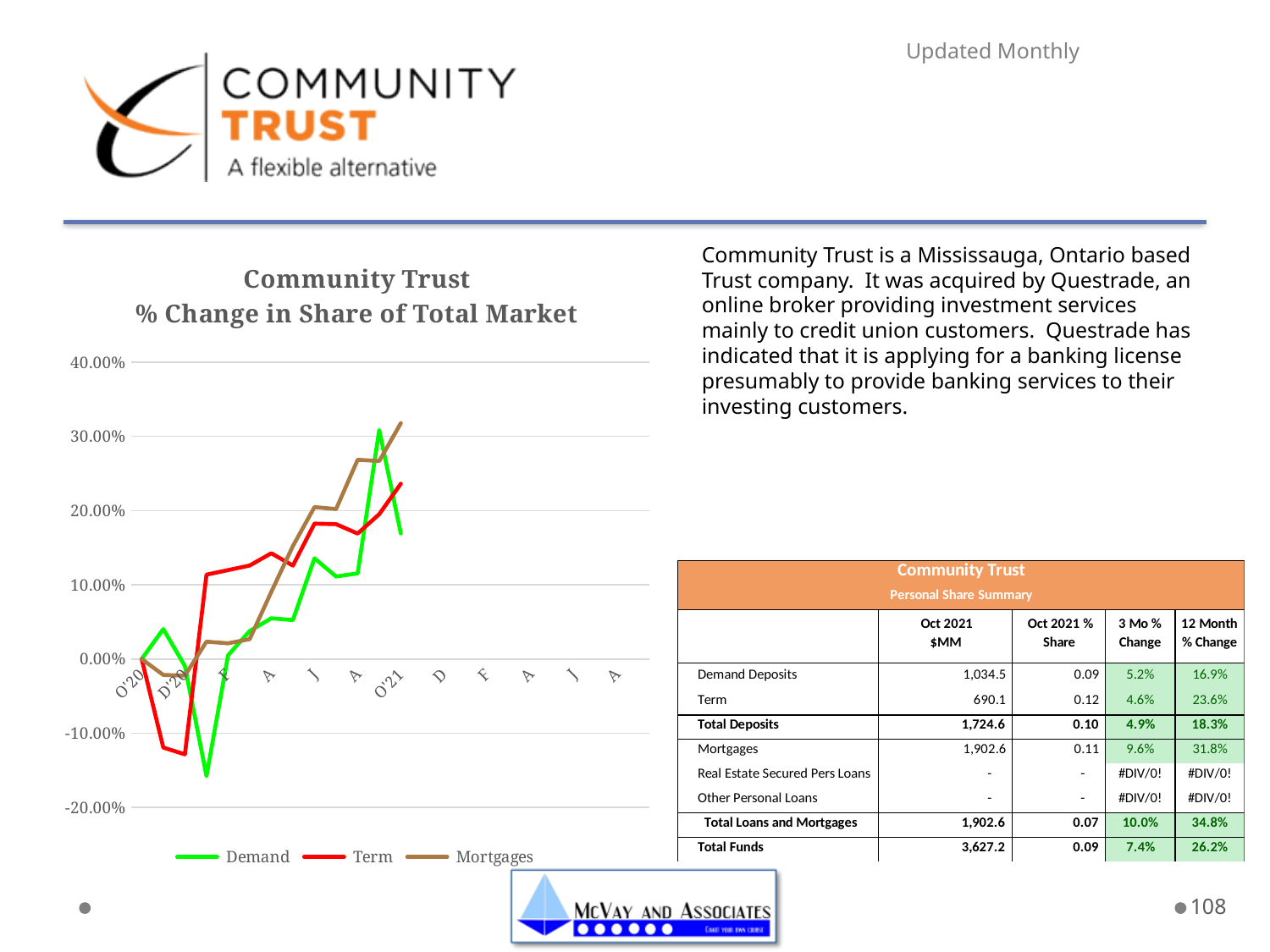
What kind of chart is shown on the slide? line chart At O'21, which is larger: the value for Mortgages or the value for Demand? Mortgages Is the lowest value reached by the Demand series greater or less than -10.00%? less How many labelled points are there along the x axis of the chart? 12 Is the value for Term at O'21 greater or less than 20.00%? greater Which colour is used for the Demand series in the chart? green What is the title of the chart? Community Trust % Change in Share of Total Market Is the value for Mortgages at O'21 greater or less than 20.00%? greater Which series has the highest value at the last point on the chart (O'21)? Mortgages Does the Mortgages series generally rise or fall from O'20 to O'21? rise How many series does the chart legend list? 3